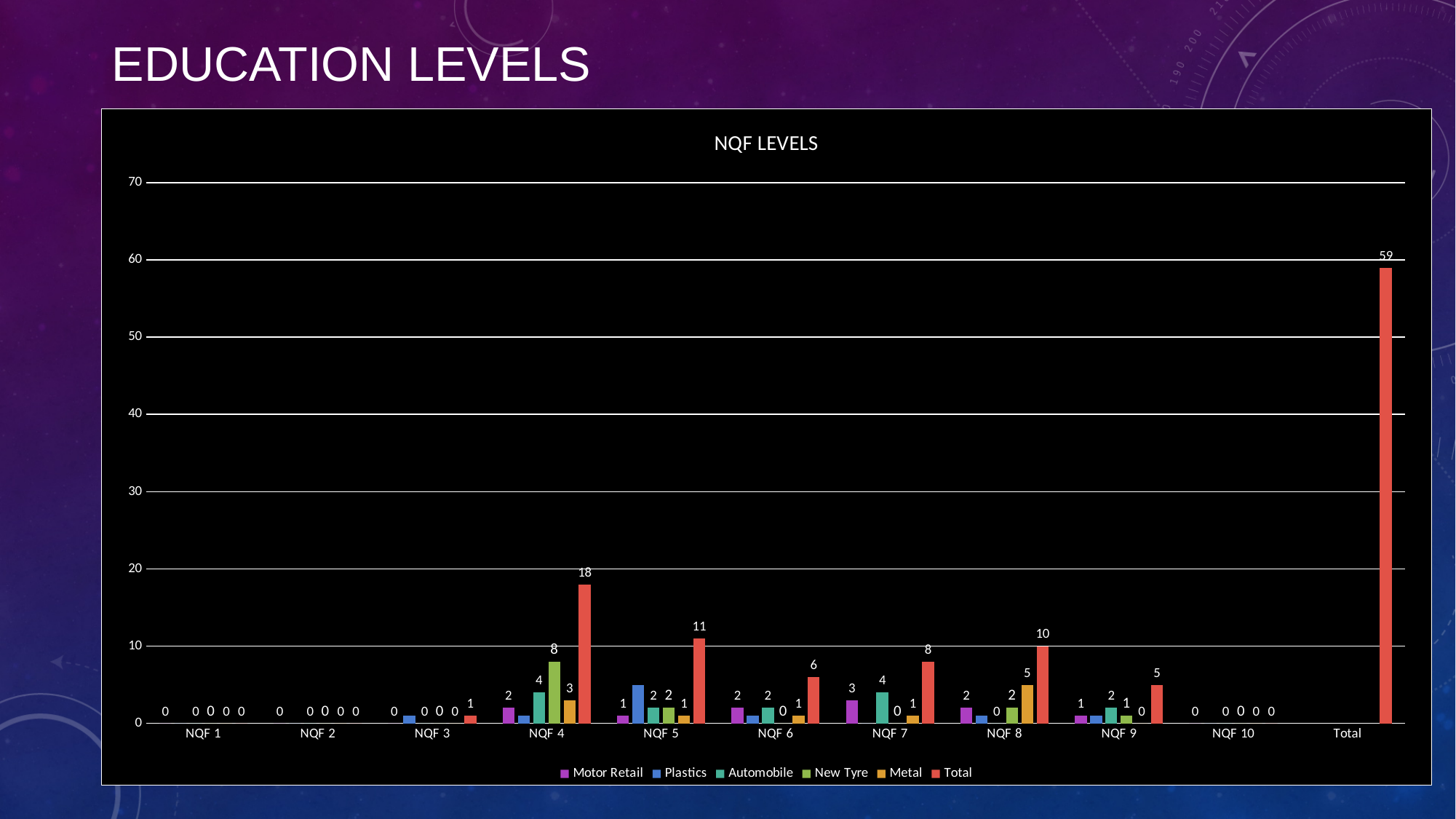
Is the Total value for the Total category greater or less than 50? greater What is the New Tyre value for NQF 4? 8 Which is larger, the Total value for NQF 7 or for NQF 8? NQF 8 How many series does the legend list? 6 What is the title of the chart? NQF LEVELS What is the difference between the Total values for NQF 4 and NQF 5? 7 What type of chart is shown on the slide? bar chart What is the Metal value for NQF 8? 5 Which NQF level (excluding the Total category) has the highest Total value? NQF 4 What is the Total value for NQF 4? 18 What is the Total value for the Total category? 59 What is the Automobile value for NQF 7? 4